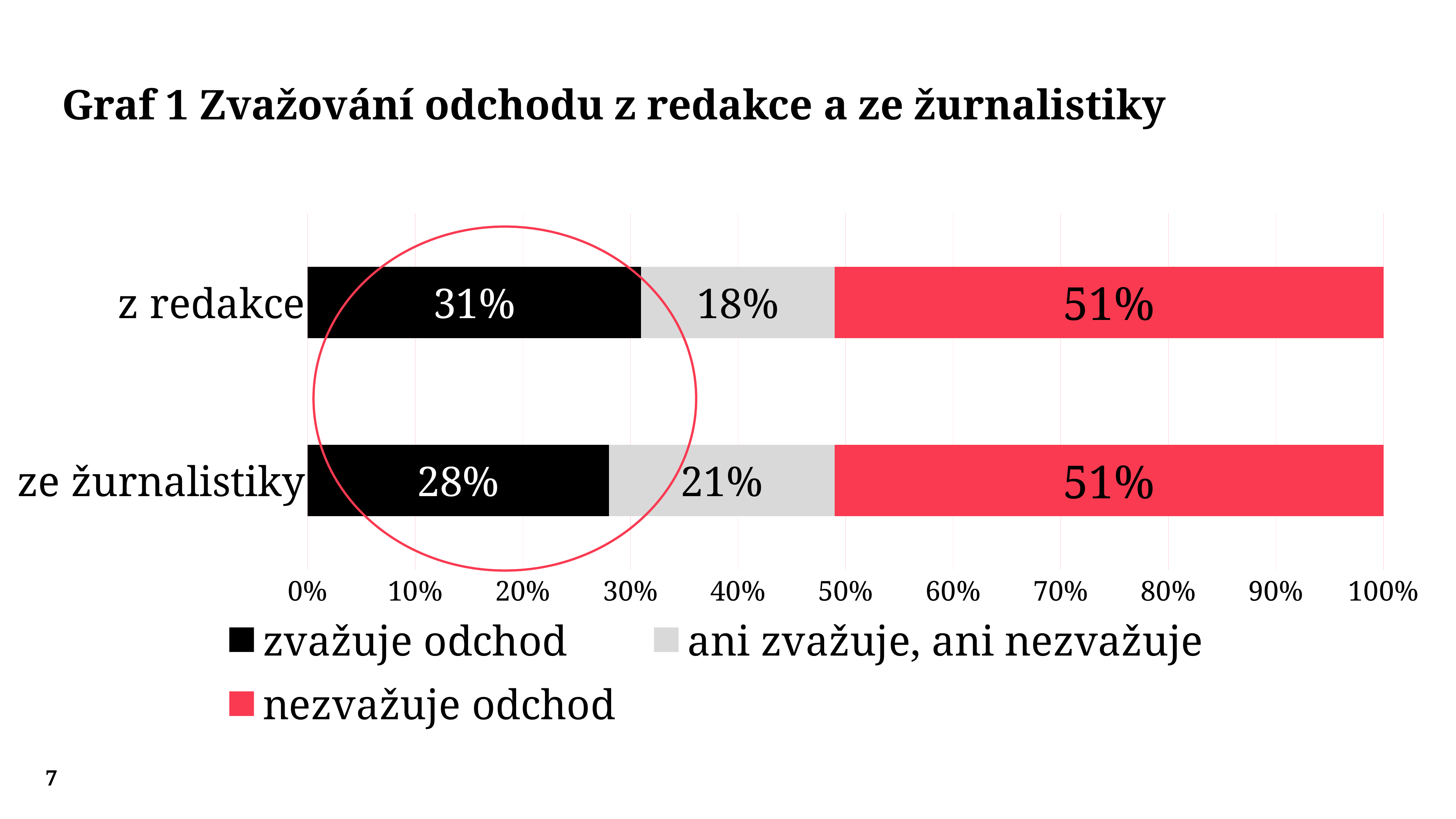
How many series does the legend list? 3 Which category has the higher value for "zvažuje odchod", "z redakce" or "ze žurnalistiky"? z redakce What is the value for "zvažuje odchod" in the "ze žurnalistiky" bar? 28% Which series has the smallest value in the "ze žurnalistiky" bar? ani zvažuje, ani nezvažuje What is the value for "nezvažuje odchod" in the "z redakce" bar? 51% What kind of chart is shown on the slide? stacked bar chart How many categories are shown on the chart? 2 What is the value for "zvažuje odchod" in the "z redakce" bar? 31% What is the difference between the "ani zvažuje, ani nezvažuje" values for "ze žurnalistiky" and "z redakce"? 3% Which series has the largest value in the "z redakce" bar? nezvažuje odchod What is the difference between the "zvažuje odchod" values for "z redakce" and "ze žurnalistiky"? 3% What is the value for "ani zvažuje, ani nezvažuje" in the "ze žurnalistiky" bar? 21%